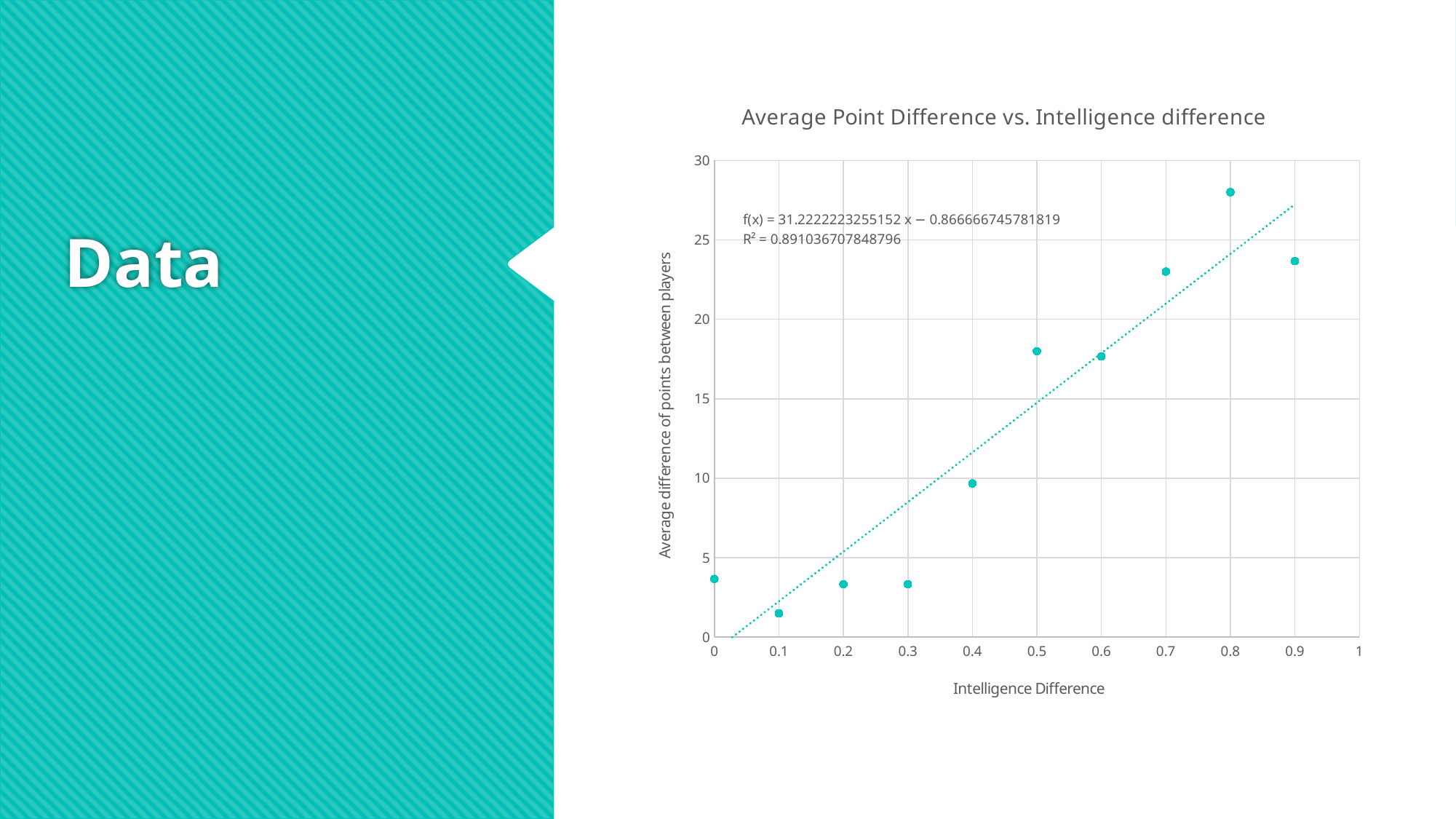
What R² value is printed on the chart for the trendline? 0.891036707848796 Which has the larger average difference of points: Intelligence Difference 0.8 or 0.9? 0.8 Is the value at Intelligence Difference 0.5 greater or less than 15? greater How many data points are plotted in the chart? 10 At which Intelligence Difference value is the average difference of points highest? 0.8 Is the value at Intelligence Difference 0.8 greater or less than 25? greater Is the value at Intelligence Difference 0.1 greater or less than 5? less Do the plotted values generally rise or fall as Intelligence Difference increases? Rise What kind of chart is shown on the slide? Scatter chart At which Intelligence Difference value is the average difference of points lowest? 0.1 What is the title of the chart? Average Point Difference vs. Intelligence difference